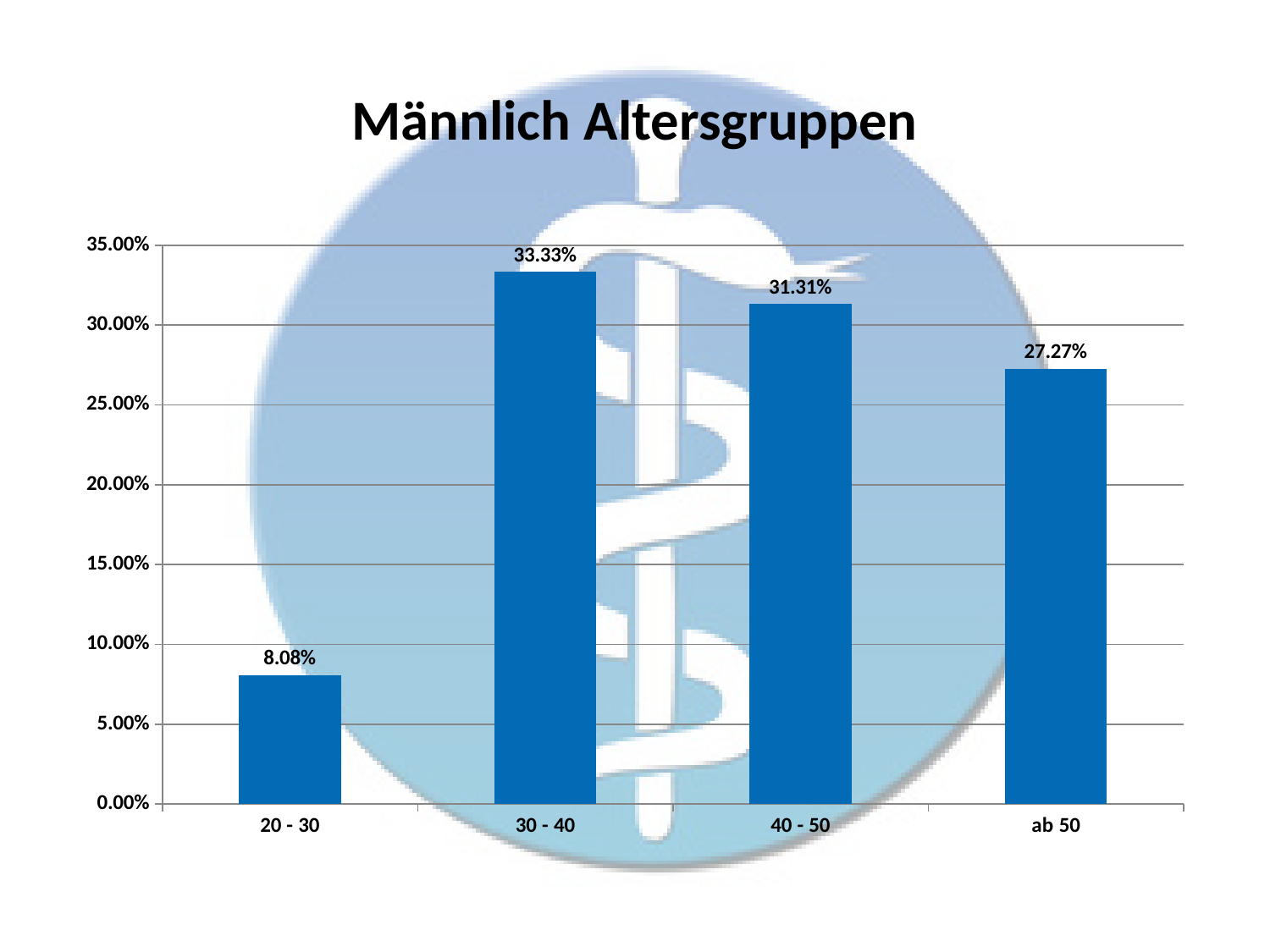
How many age groups are shown in the chart? 4 What is the value for the 30 - 40 age group? 33.33% Which age group has the lowest value? 20 - 30 What is the difference between the values for ab 50 and 20 - 30? 19.19% What kind of chart is shown on the slide? Bar chart Is the value for ab 50 greater or less than 25.00%? greater What is the value for the 40 - 50 age group? 31.31% What is the value for the 20 - 30 age group? 8.08% What is the value for the ab 50 age group? 27.27% Which is larger, the value for 40 - 50 or the value for ab 50? 40 - 50 What is the difference between the values for 30 - 40 and 40 - 50? 2.02% Which age group has the highest value? 30 - 40